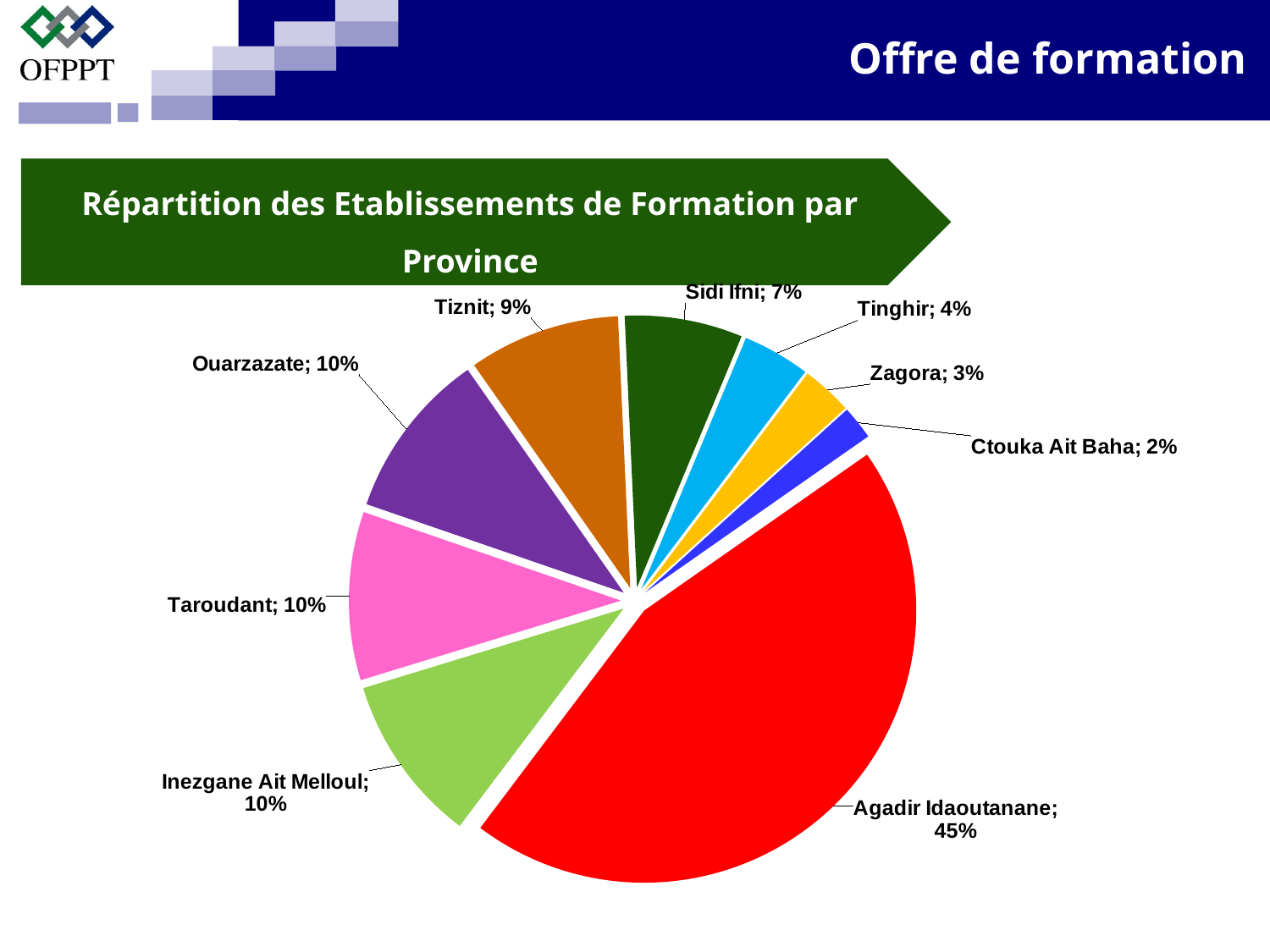
How many provinces (slices) are shown in the pie chart? 9 What is the difference between the values for Tinghir and Zagora? 1% What is the value shown for Sidi Ifni? 7% What is the difference between the values for Agadir Idaoutanane and Taroudant? 35% Which province has the largest slice of the pie? Agadir Idaoutanane What is the value shown for Tiznit? 9% What is the title of the chart? Répartition des Etablissements de Formation par Province Which is larger, the value for Sidi Ifni or the value for Tinghir? Sidi Ifni What kind of chart is shown on the slide? pie chart What share of the pie does Agadir Idaoutanane hold? 45% Which province has the smallest slice of the pie? Ctouka Ait Baha What is the value shown for Ctouka Ait Baha? 2%